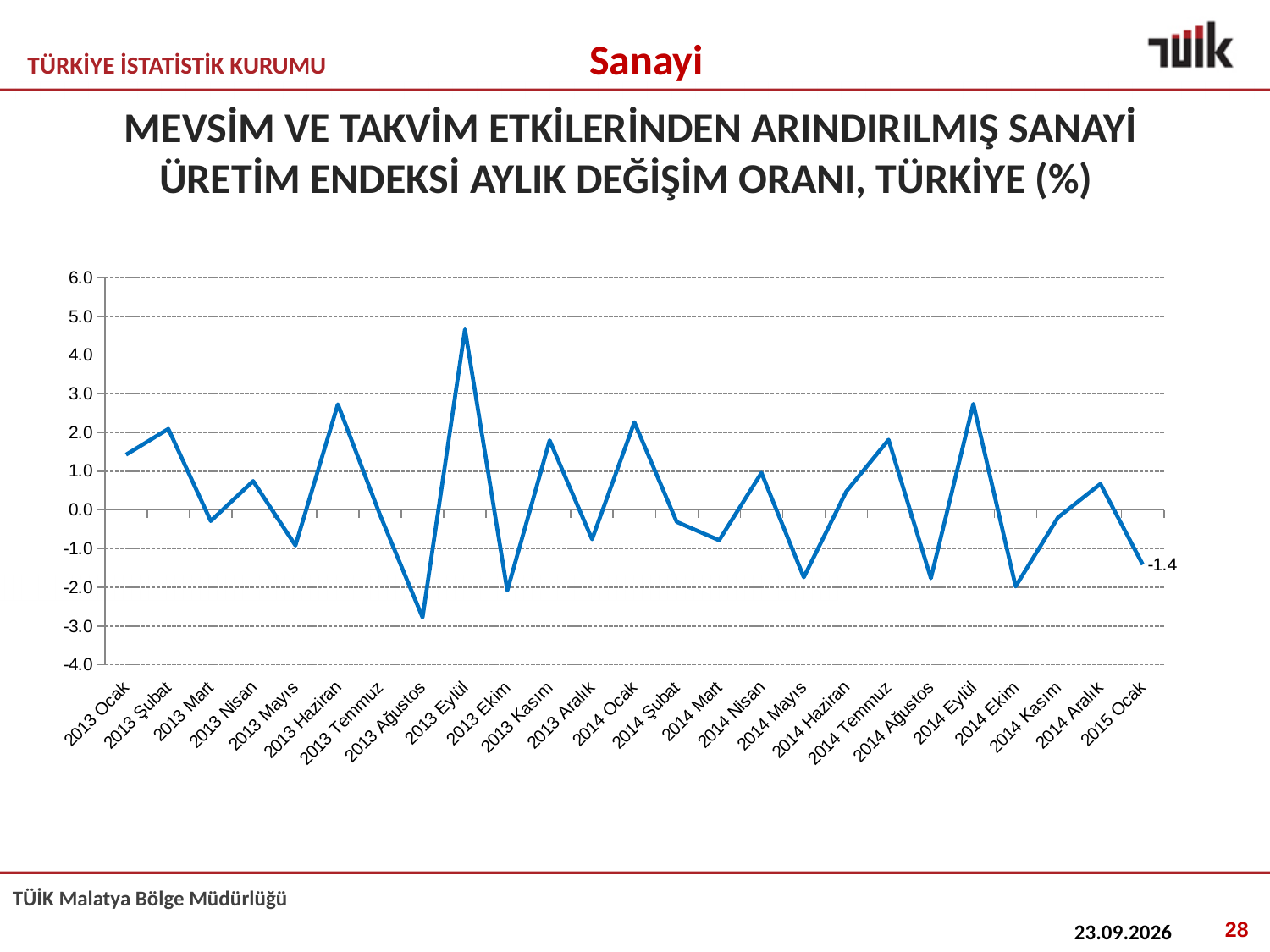
Which month has the highest value on the chart? 2013 Eylül Is the value for 2013 Eylül greater or less than 4.0? greater Is the value for 2013 Ağustos greater or less than -2.0? less Is the value for 2014 Ekim greater or less than -1.0? less Which month has the lowest value on the chart? 2013 Ağustos What is the title of the chart? MEVSİM VE TAKVİM ETKİLERİNDEN ARINDIRILMIŞ SANAYİ ÜRETİM ENDEKSİ AYLIK DEĞİŞİM ORANI, TÜRKİYE (%) How many months are plotted on the x axis? 25 What kind of chart is shown on the slide? line chart What is the value for 2015 Ocak? -1.4 Which is larger, the value for 2013 Eylül or the value for 2014 Ocak? 2013 Eylül Do the values rise or fall from 2013 Haziran to 2013 Ağustos? fall